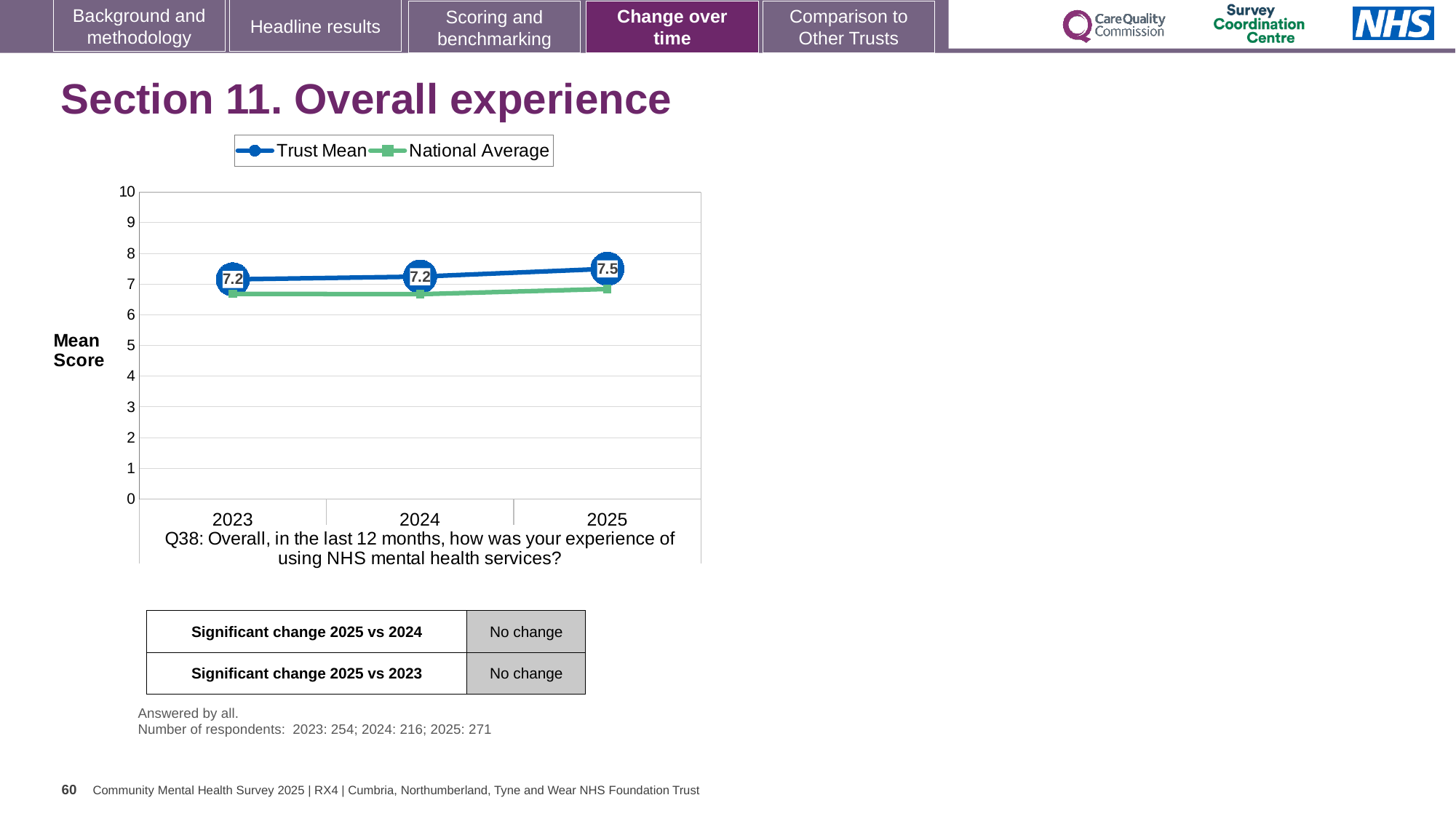
How many series does the legend list? 2 By how much did the Trust Mean score change from 2023 to 2025? 0.3 Is the National Average value for 2023 greater or less than 7? less Is the National Average value for 2025 greater or less than 6? greater In which year is the Trust Mean score highest? 2025 What is the Trust Mean score for 2024? 7.2 How many years are plotted on the x axis? 3 What is the label on the y axis of the chart? Mean Score What kind of chart is shown on the slide? Line chart In 2025, which is higher: the Trust Mean or the National Average? Trust Mean What is the Trust Mean score for 2023? 7.2 What is the Trust Mean score for 2025? 7.5